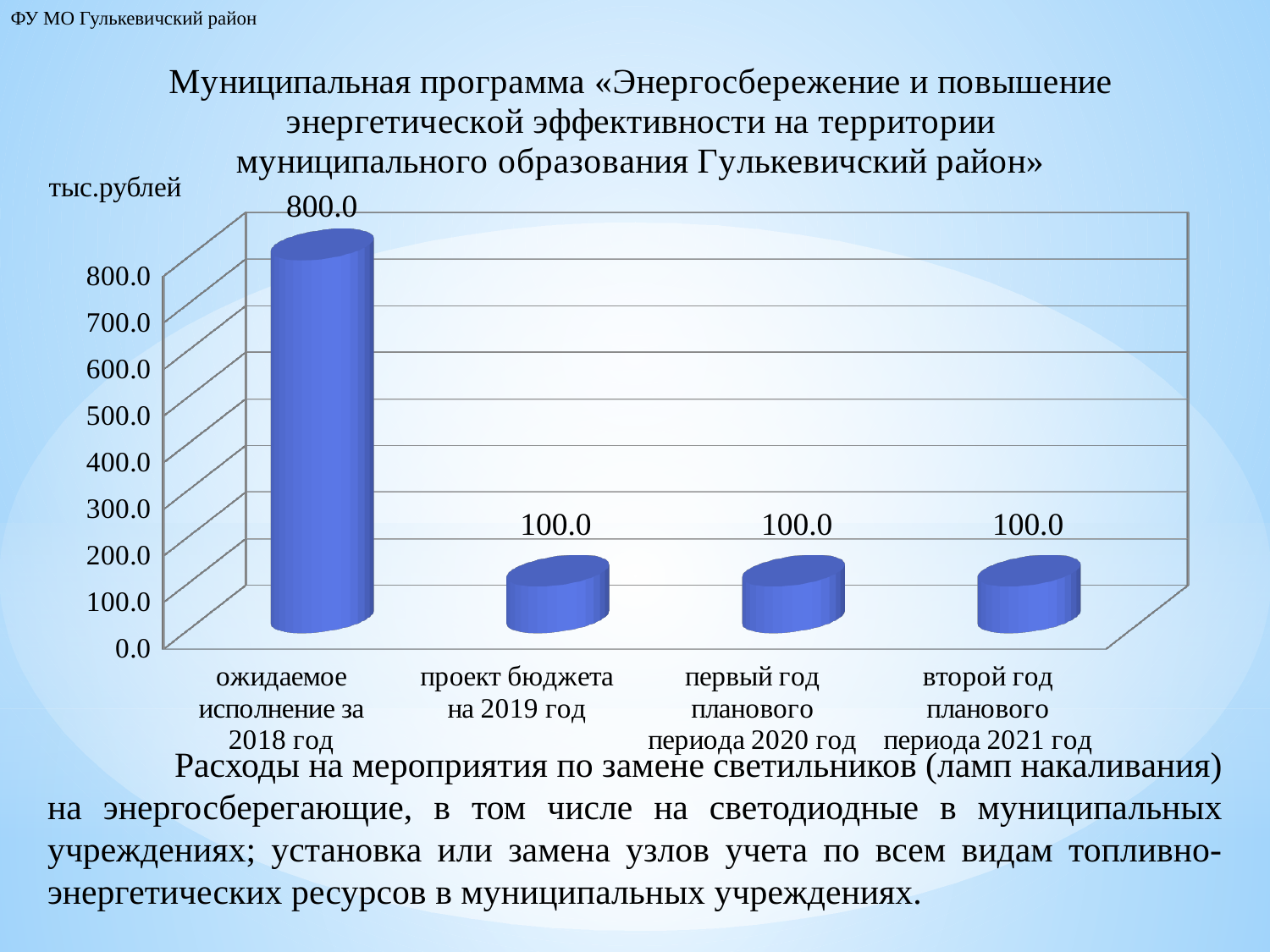
What colour are the bars on the chart? blue Which category has the highest value? ожидаемое исполнение за 2018 год Which is larger: the value for "ожидаемое исполнение за 2018 год" or the value for "первый год планового периода 2020 год"? ожидаемое исполнение за 2018 год How many categories are shown on the chart? 4 What kind of chart is shown on the slide? bar chart What unit is indicated for the values on the chart? тыс.рублей What is the value for "ожидаемое исполнение за 2018 год"? 800.0 Is the value for "ожидаемое исполнение за 2018 год" greater or less than 500.0? greater What is the value for "второй год планового периода 2021 год"? 100.0 What is the difference between the value for 2018 and the value for 2019? 700.0 Do the values rise or fall from the 2018 category to the 2019 category? fall What is the value for "проект бюджета на 2019 год"? 100.0